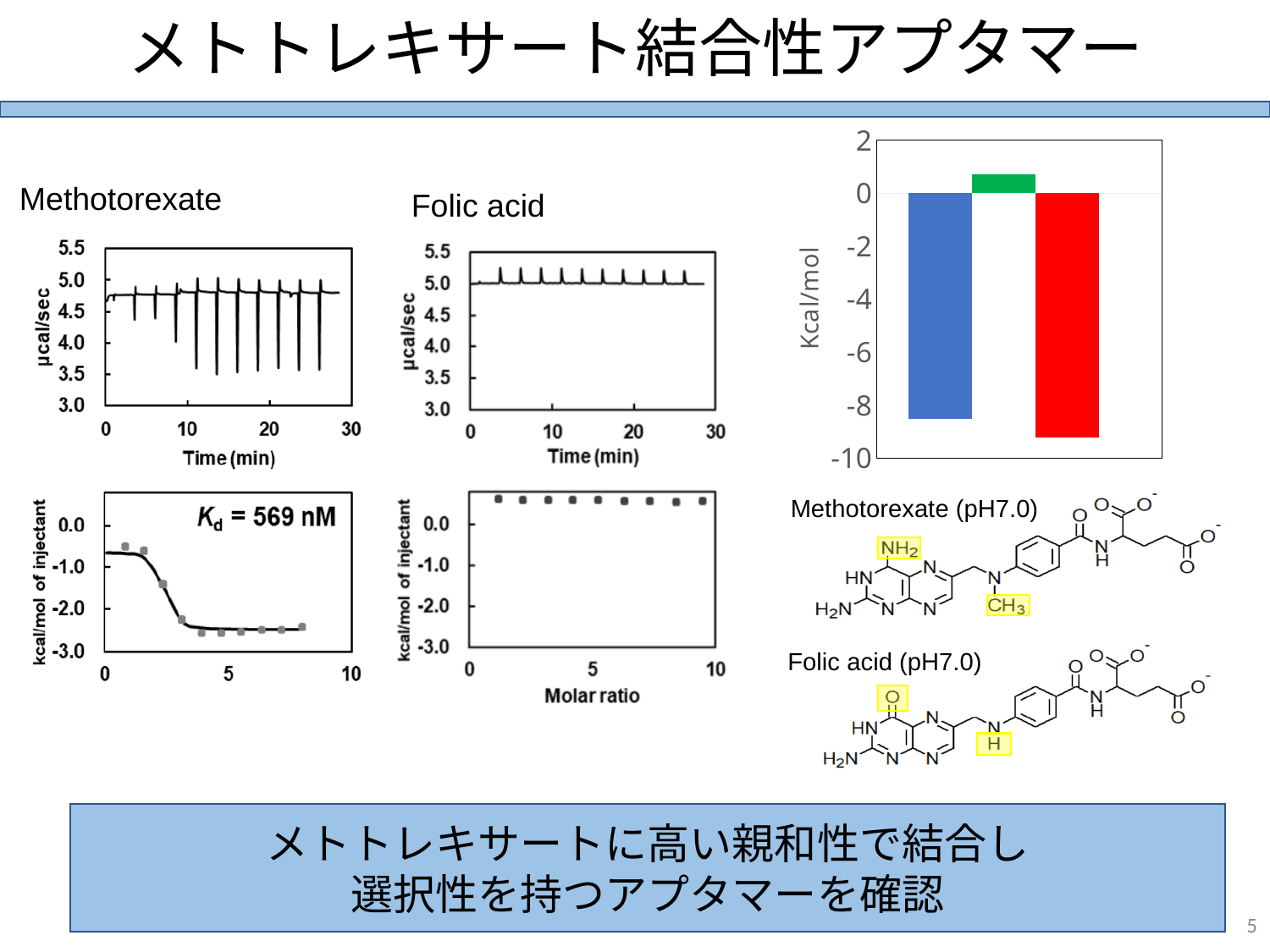
How many bars are plotted in the bar chart at the top right of the slide? 3 In the bar chart at the top right, is the value of the red bar greater or less than -8? less What kind of chart is shown at the top right of the slide? bar chart What is the highest tick value shown on the vertical axis of the bar chart at the top right? 2 In the bar chart at the top right, which is larger, the value of the blue bar or the value of the green bar? green bar In the bar chart at the top right, is the value of the blue bar greater or less than -10? greater In the bar chart at the top right, is the value of the green bar greater or less than 0? greater In the bar chart at the top right, which bar (by colour) has the lowest value? red What is the label on the vertical axis of the bar chart at the top right? Kcal/mol In the bar chart at the top right, which bar (by colour) has the highest value? green What Kd value is printed on the Methotorexate binding plot on the left of the slide? 569 nM In the bar chart at the top right, which is larger, the value of the blue bar or the value of the red bar? blue bar